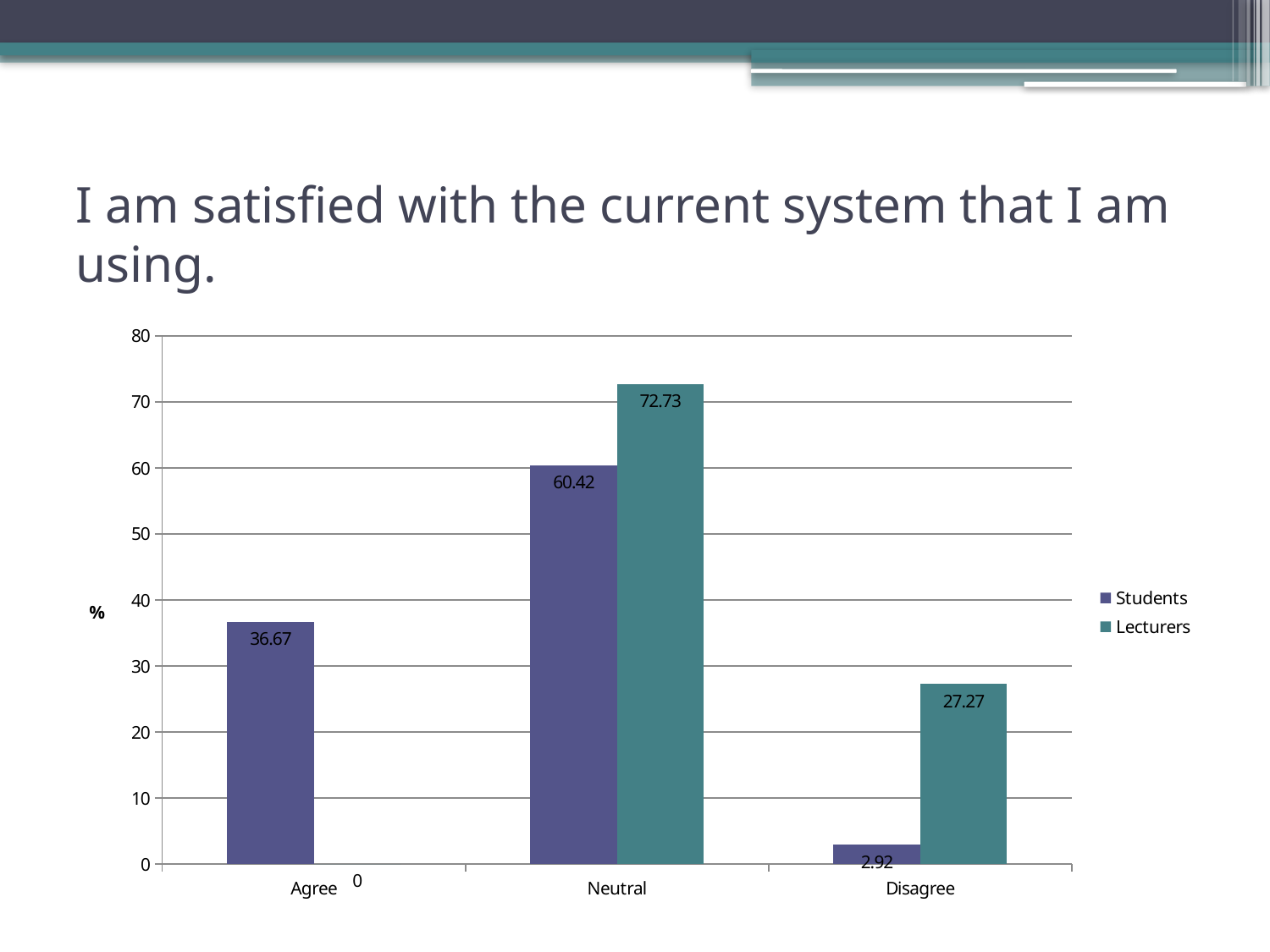
Which category has the highest value for Lecturers? Neutral How many series does the legend list? 2 Which category has the lowest value for Students? Disagree How many categories are shown on the x axis? 3 What is the difference between the Lecturers and Students values in the Neutral category? 12.31 What is the label on the vertical axis? % What is the value for Students in the Agree category? 36.67 What is the value for Students in the Disagree category? 2.92 What is the value for Lecturers in the Neutral category? 72.73 What kind of chart is shown on the slide? Bar chart In the Disagree category, which series has the larger value, Students or Lecturers? Lecturers What is the value for Lecturers in the Agree category? 0